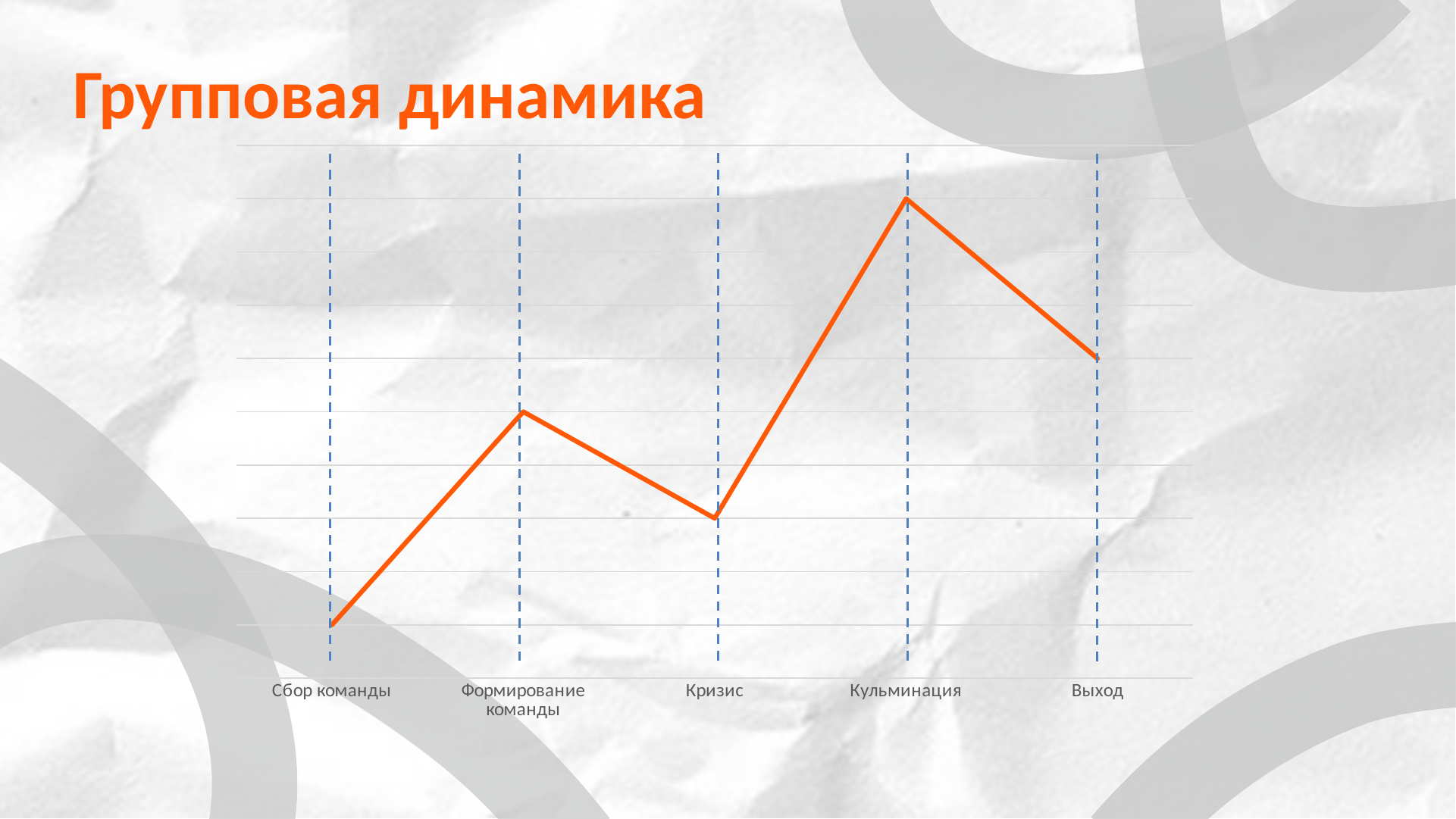
Which is higher on the chart, Формирование команды or Кризис? Формирование команды Which category has the highest point on the line? Кульминация Which is higher on the chart, Кульминация or Выход? Кульминация What kind of chart is shown on the slide? line chart Does the line rise or fall from Сбор команды to Формирование команды? rise What is the title of the chart on the slide? Групповая динамика Which category has the lowest point on the line? Сбор команды How many categories are plotted along the x axis of the chart? 5 Which is higher on the chart, Выход or Кризис? Выход Does the line rise or fall from Формирование команды to Кризис? fall What colour is the plotted line on the chart? orange Does the line rise or fall from Кульминация to Выход? fall